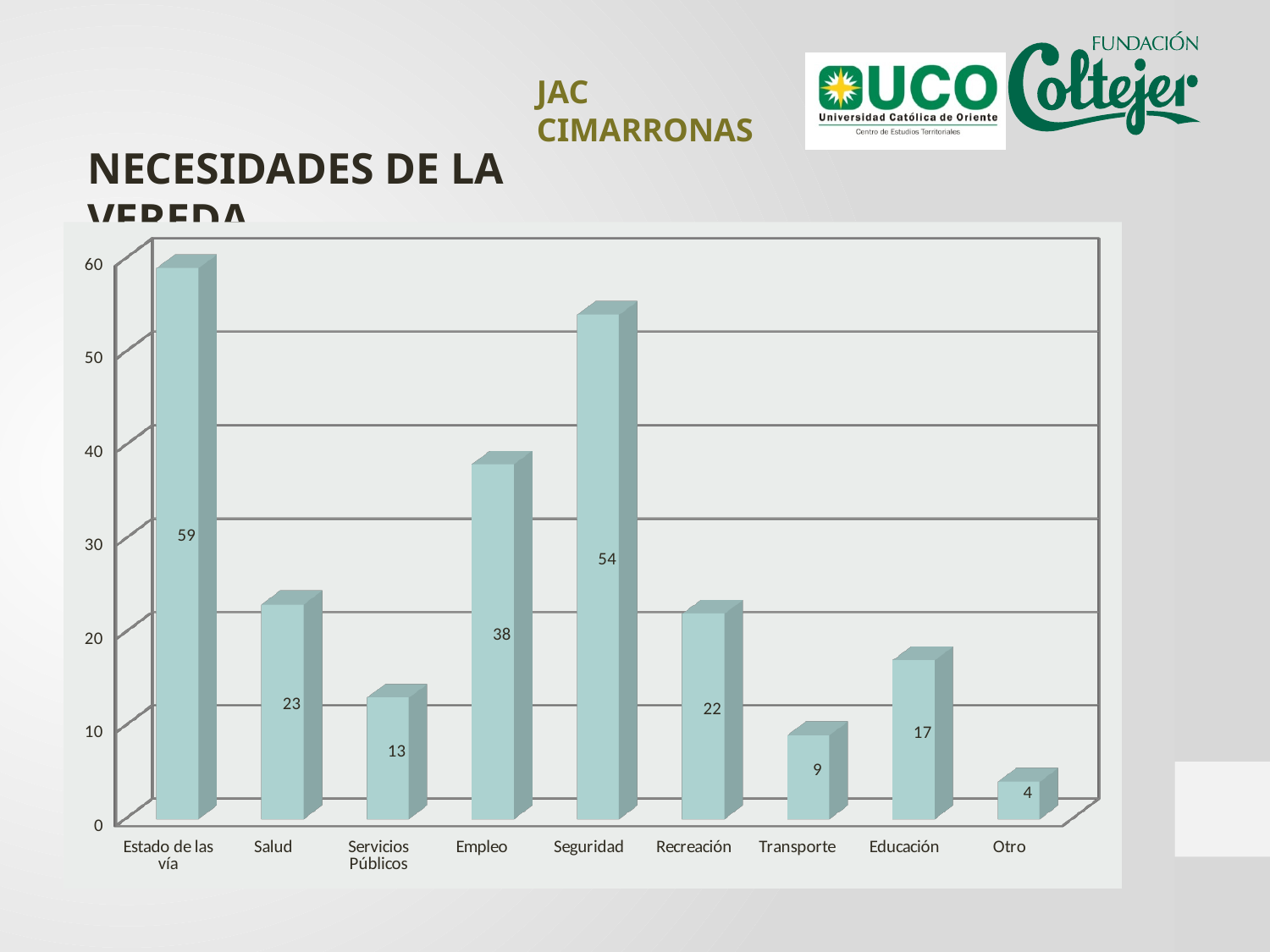
Which category has the highest value? Estado de las vía What is the value for Educación? 17 What is the difference between the values for Empleo and Salud? 15 Which is larger, the value for Recreación or the value for Servicios Públicos? Recreación What is the value for Seguridad? 54 How many categories are shown on the x axis? 9 Is the value for Empleo greater or less than 30? greater What is the value for Transporte? 9 Which category has the lowest value? Otro What is the value for Estado de las vía? 59 What kind of chart is shown on the slide? bar chart